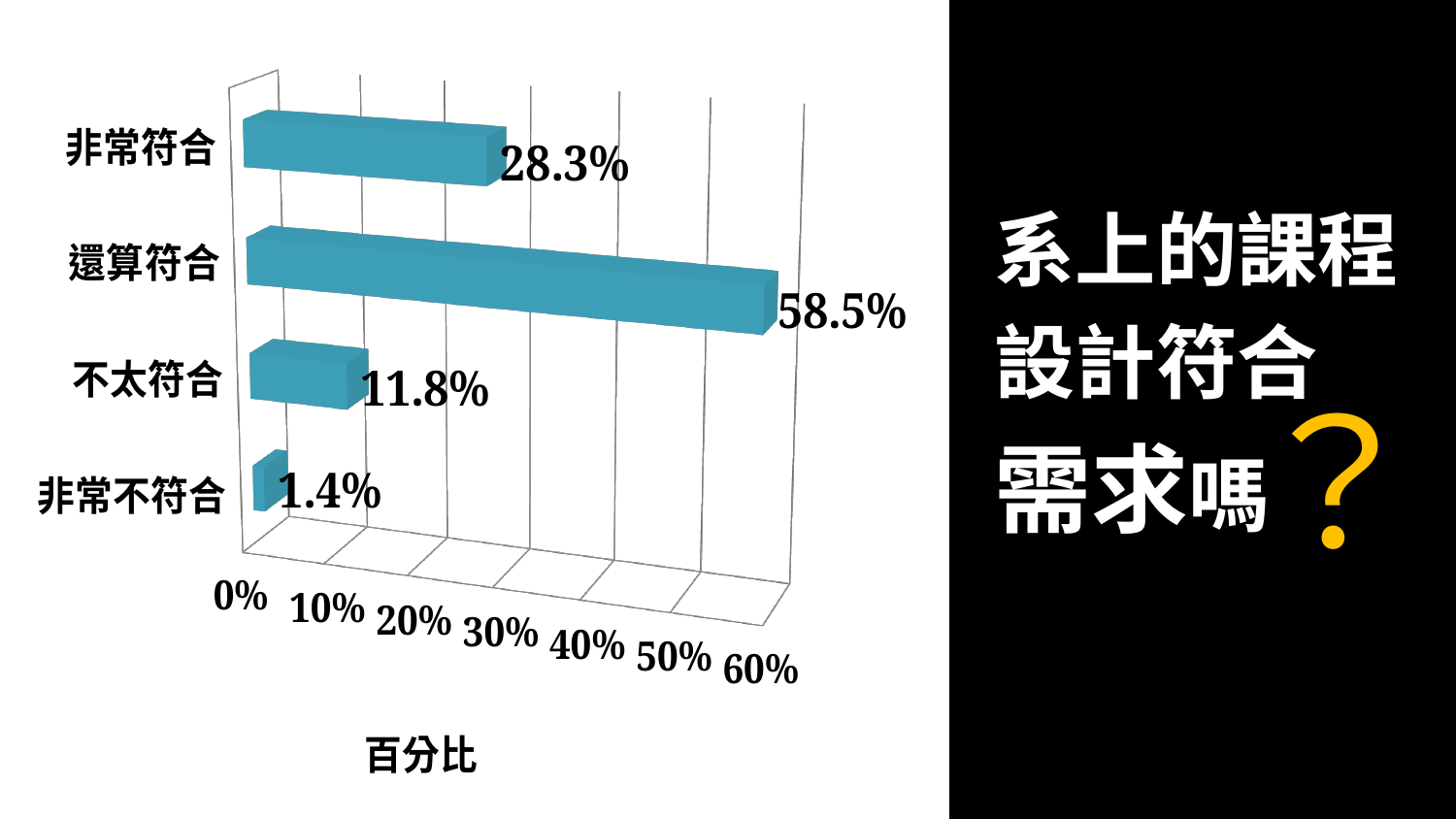
Which is larger, the value for 非常符合 or the value for 不太符合? 非常符合 What is the value for 不太符合? 11.8% Is the value for 還算符合 greater or less than 50%? greater What is the value for 非常符合? 28.3% What is the value for 還算符合? 58.5% Which category has the highest value? 還算符合 What is the difference between the values for 還算符合 and 非常符合? 30.2% What is the label of the horizontal axis? 百分比 Which category has the lowest value? 非常不符合 What is the value for 非常不符合? 1.4% How many categories are shown in the chart? 4 What kind of chart is shown on the slide? bar chart